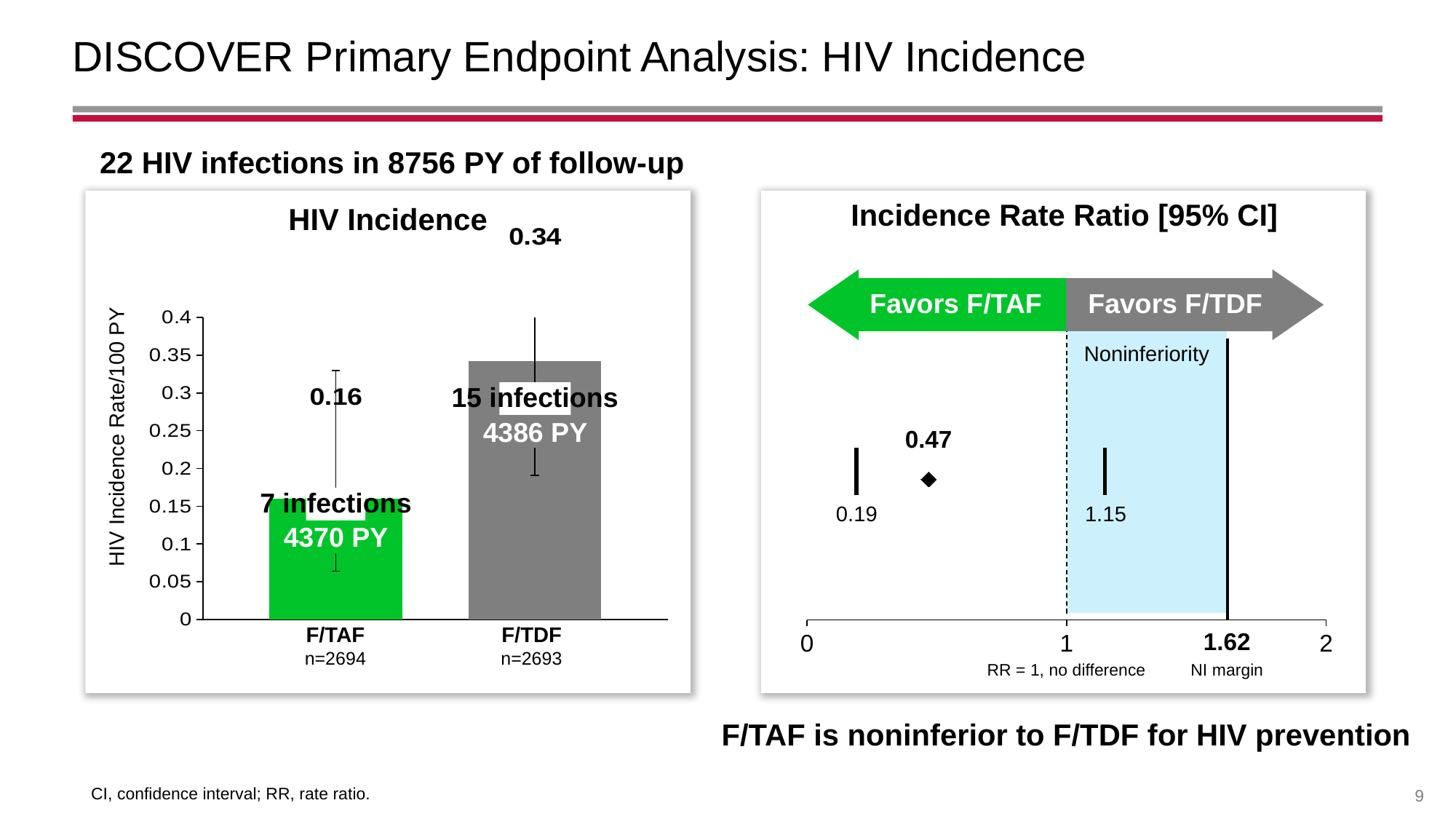
In the Incidence Rate Ratio chart, what value is marked as the NI margin? 1.62 In the HIV Incidence chart, what is the HIV incidence rate per 100 PY for F/TAF? 0.16 In the HIV Incidence chart, how many infections were observed in the F/TAF arm? 7 infections In the Incidence Rate Ratio chart, what is the point estimate of the incidence rate ratio? 0.47 What kind of chart is the HIV Incidence chart? Bar chart In the HIV Incidence chart, how many person-years of follow-up are shown for the F/TDF arm? 4386 PY In the Incidence Rate Ratio chart, what is the upper bound of the 95% CI? 1.15 In the HIV Incidence chart, what is the HIV incidence rate per 100 PY for F/TDF? 0.34 In the HIV Incidence chart, which arm has the lower HIV incidence rate? F/TAF How many bars are plotted in the HIV Incidence chart? 2 In the HIV Incidence chart, which arm has the higher HIV incidence rate? F/TDF In the HIV Incidence chart, what is the difference between the F/TDF and F/TAF incidence rates? 0.18